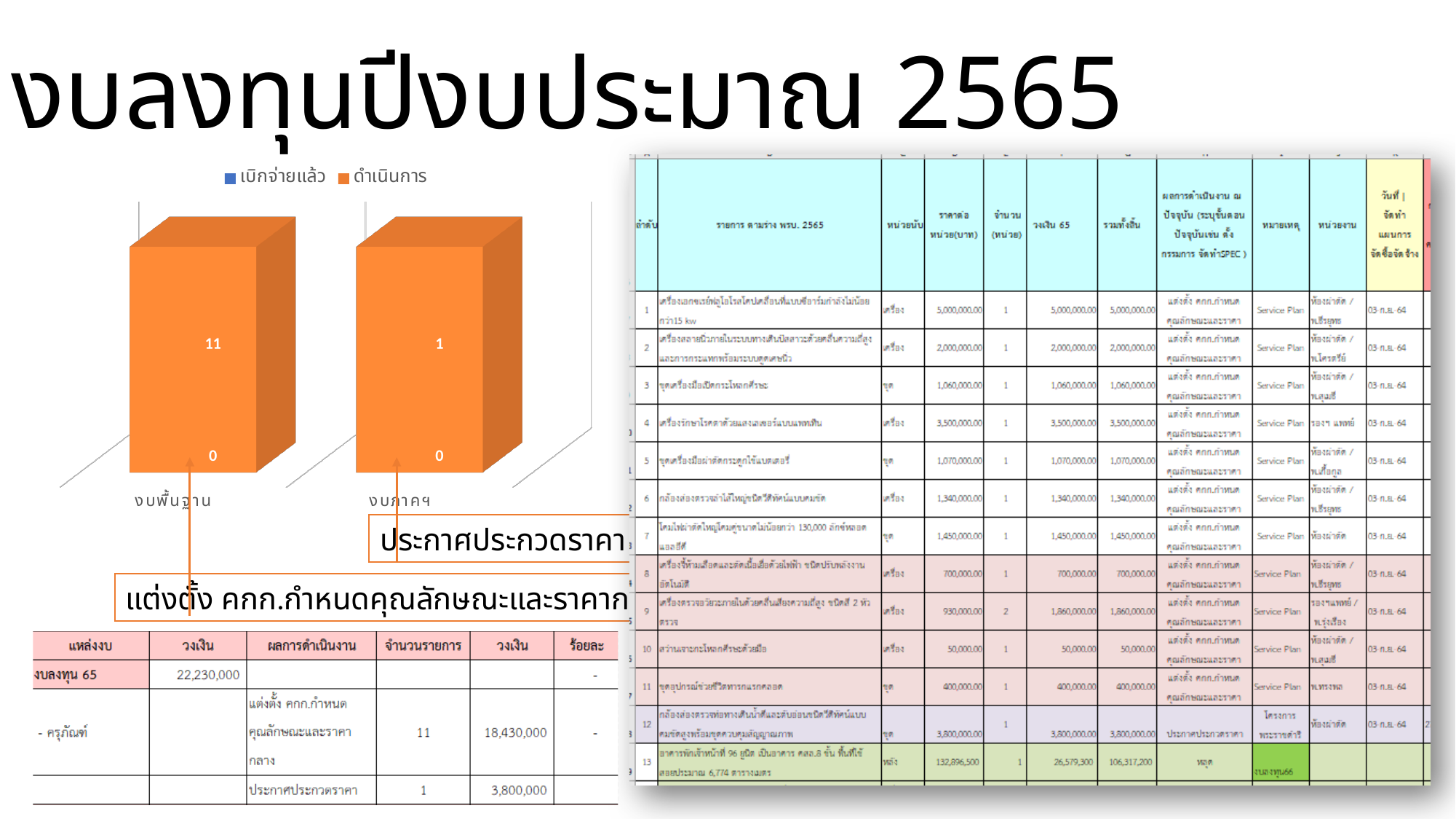
What is the total of the stacked bar for งบพื้นฐาน? 11 Which category has the lowest ดำเนินการ value? งบภาคฯ How many series does the chart legend list? 2 What is the value of ดำเนินการ for งบภาคฯ? 1 What is the value of เบิกจ่ายแล้ว for งบพื้นฐาน? 0 Which category has the highest ดำเนินการ value? งบพื้นฐาน How many categories are shown on the chart's x axis? 2 What is the value of ดำเนินการ for งบพื้นฐาน? 11 What is the difference between the ดำเนินการ values for งบพื้นฐาน and งบภาคฯ? 10 Which colour represents the ดำเนินการ series in the chart? orange What is the value of เบิกจ่ายแล้ว for งบภาคฯ? 0 What kind of chart is shown on the left of the slide? bar chart